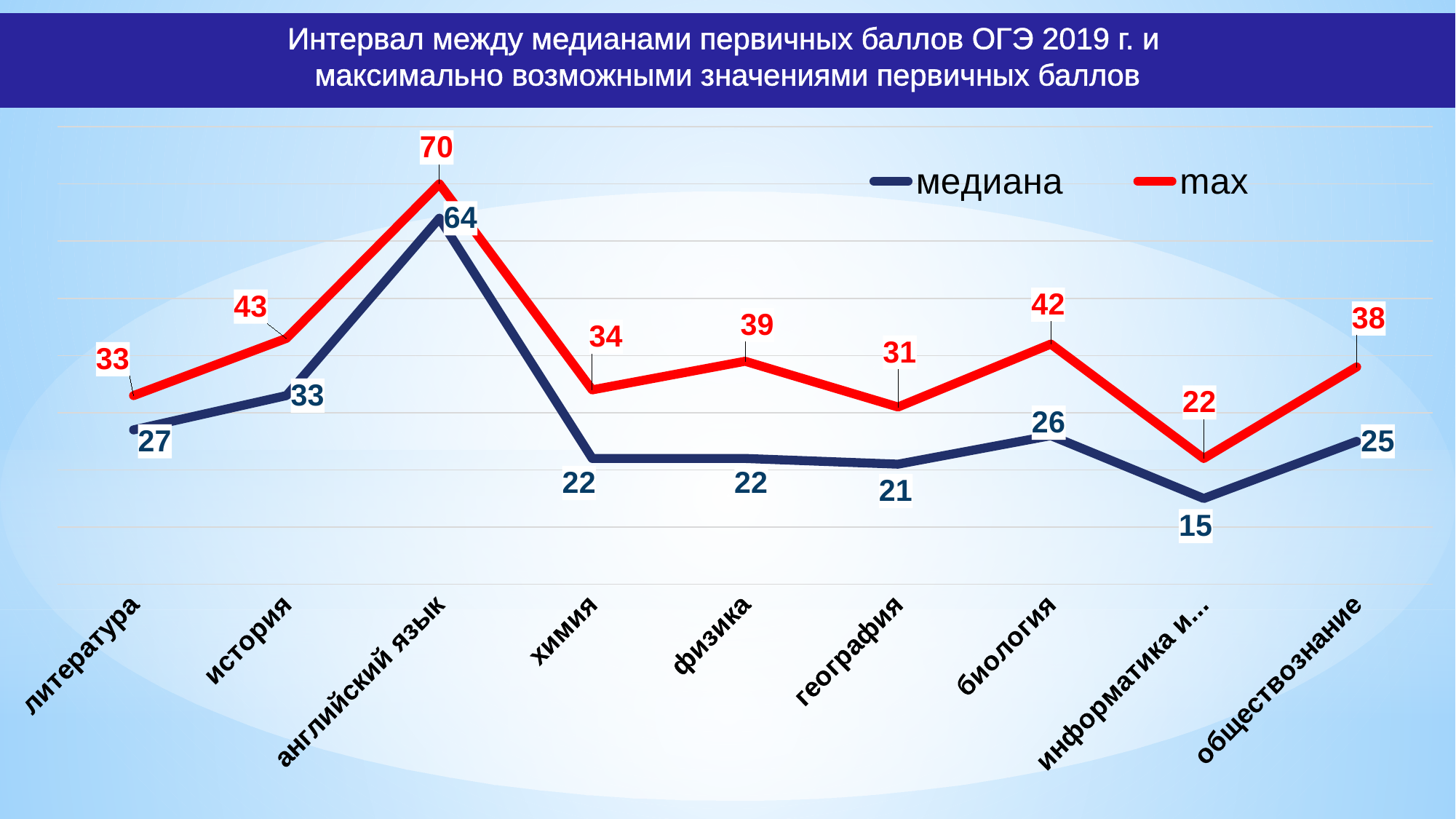
What is the max value for обществознание? 38 What is the difference between the max and медиана values for история? 10 What is the difference between the max and медиана values for физика? 17 How many series does the legend list? 2 Which category has the highest max value? английский язык Which category has the highest медиана value? английский язык What kind of chart is shown on the slide? line chart Which has the larger медиана value, история or литература? история How many categories are shown on the x axis? 9 What is the max value for биология? 42 What is the медиана value for химия? 22 What is the difference between the max and медиана values for английский язык? 6